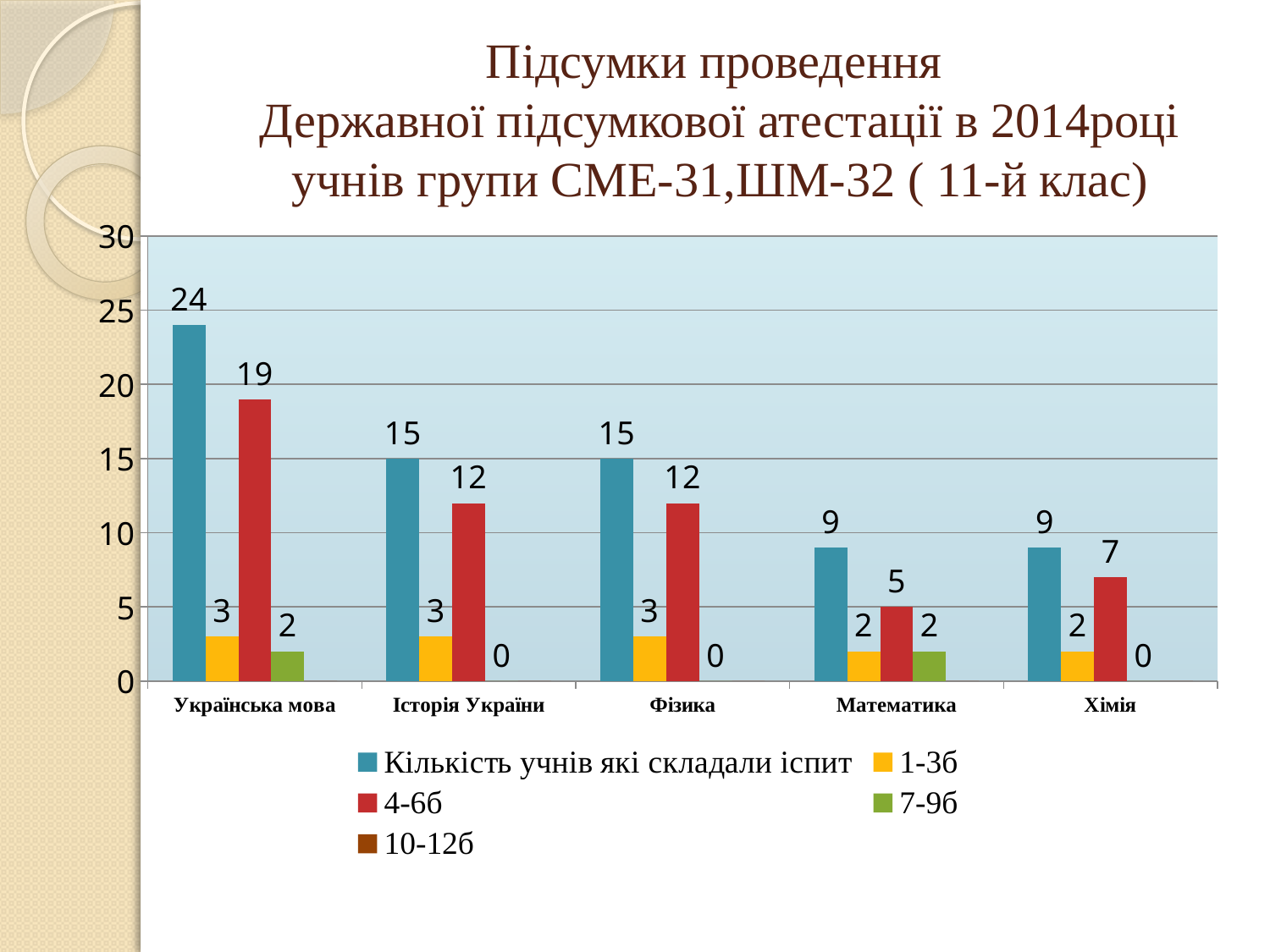
What is the value of the '4-6б' series for Хімія? 7 Which subject has the lowest value for the '4-6б' series? Математика Which is larger: the '4-6б' value for Математика or for Хімія? Хімія What is the value of 'Кількість учнів які складали іспит' for Українська мова? 24 What colour are the bars for the '1-3б' series? yellow How many subject categories are shown on the x axis? 5 Is the value of 'Кількість учнів які складали іспит' for Історія України greater or less than 10? greater How many series does the legend list? 5 What kind of chart is shown on the slide? bar chart What is the value of the '7-9б' series for Математика? 2 Which subject has the highest value for 'Кількість учнів які складали іспит'? Українська мова What is the difference between the '4-6б' values for Українська мова and Фізика? 7